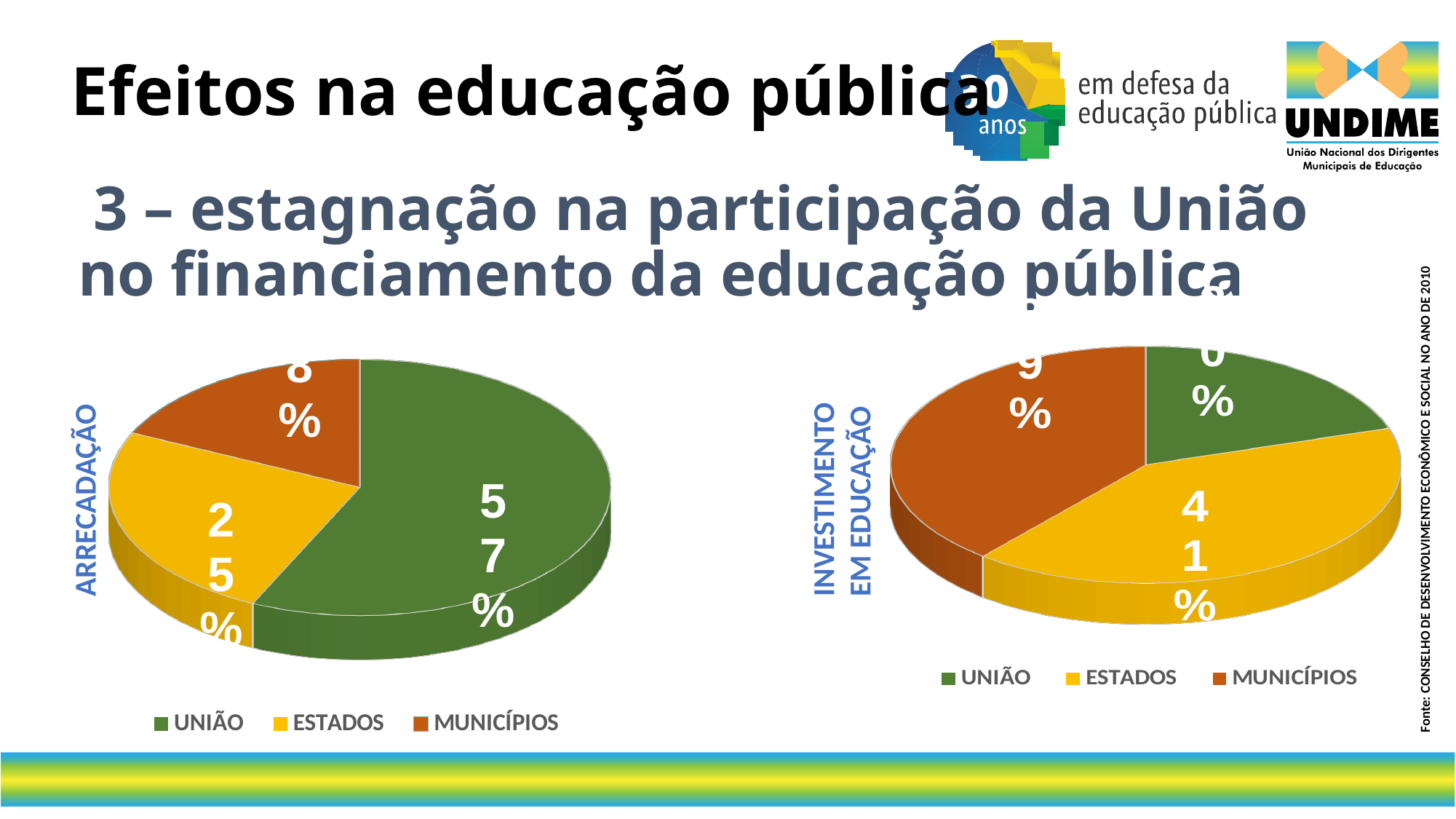
How many categories does the legend of the INVESTIMENTO EM EDUCAÇÃO pie chart list? 3 On the ARRECADAÇÃO pie chart, which is larger, UNIÃO or ESTADOS? UNIÃO On the ARRECADAÇÃO pie chart, which category has the smallest slice? MUNICÍPIOS On the ARRECADAÇÃO pie chart, which colour represents ESTADOS? Yellow On the INVESTIMENTO EM EDUCAÇÃO pie chart, which category has the smallest slice? UNIÃO On the ARRECADAÇÃO pie chart, what share is shown for ESTADOS? 25% On the ARRECADAÇÃO pie chart, which category has the largest slice? UNIÃO On the ARRECADAÇÃO pie chart, what share is shown for UNIÃO? 57% On the INVESTIMENTO EM EDUCAÇÃO pie chart, what share is shown for ESTADOS? 41% How many pie charts are shown on the slide? 2 What type of chart is used for ARRECADAÇÃO and INVESTIMENTO EM EDUCAÇÃO? Pie chart On the ARRECADAÇÃO pie chart, what is the difference in percentage points between UNIÃO and ESTADOS? 32 percentage points